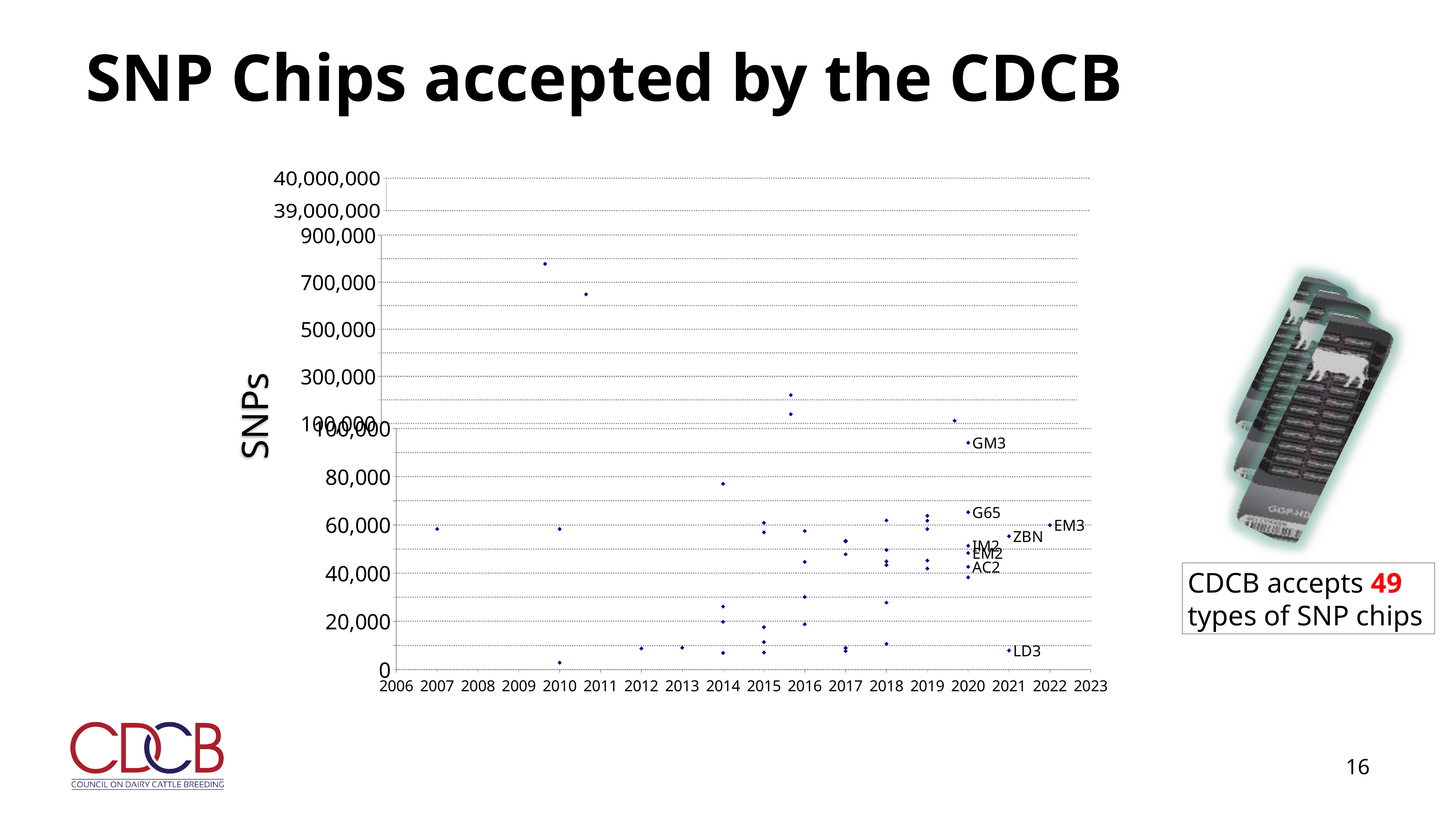
Is the value for LD3 greater or less than 20,000? less How many data points on the chart are labelled with a chip name? 8 Which has the larger SNP value, GM3 or G65? GM3 Which has the larger SNP value, LD3 or ZBN? ZBN What is the label on the y axis of the chart? SNPs Which labelled chip has the lowest SNP value on the chart? LD3 What kind of chart is shown on the slide? scatter chart What range of years does the x axis of the chart cover? 2006 to 2023 Is the highest point plotted in 2010 greater or less than 700,000? greater Which labelled chip has the highest SNP value on the chart? GM3 Is the value for ZBN greater or less than 40,000? greater